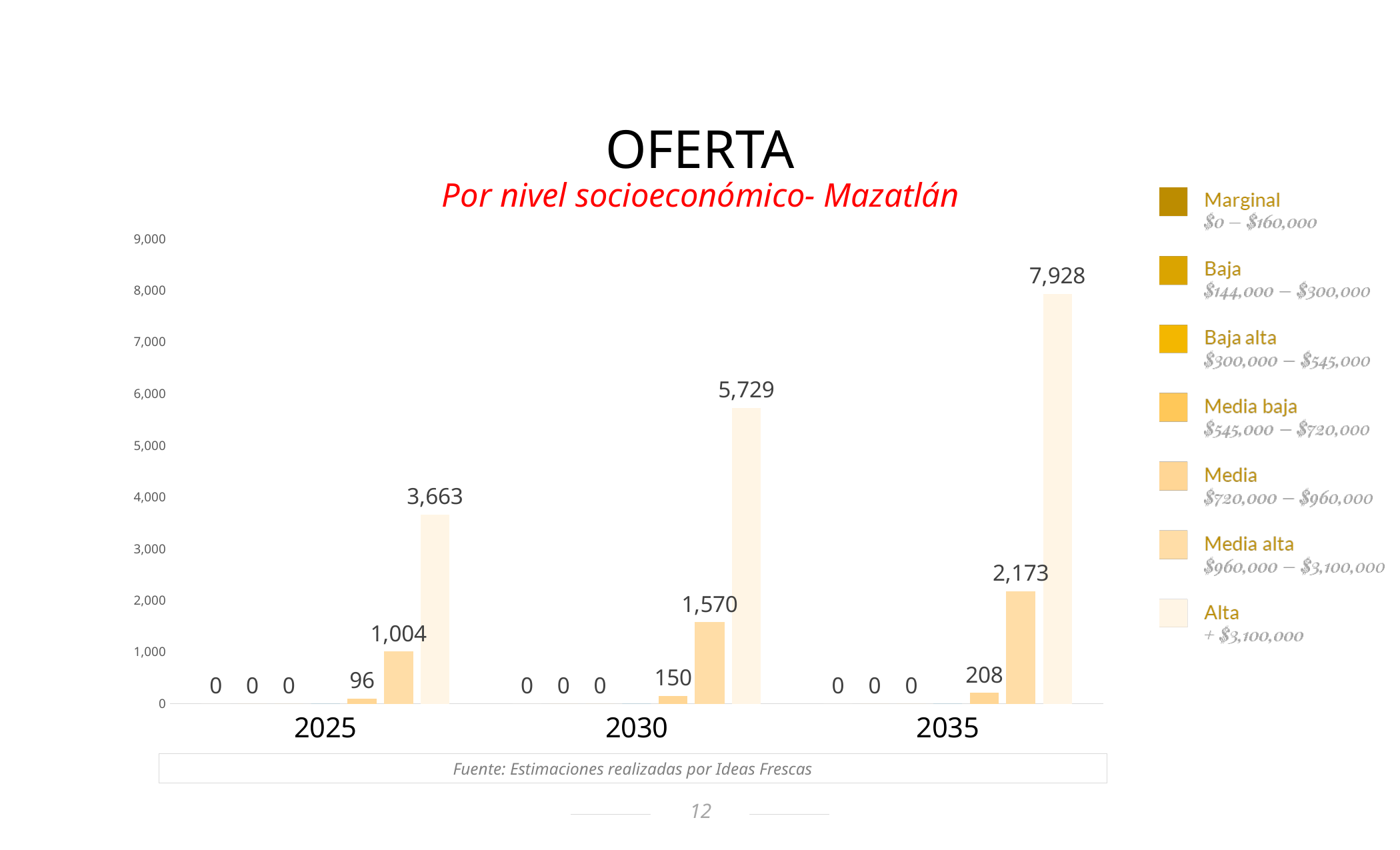
What is the difference between the second-tallest bar in 2035 (2,173) and the second-tallest bar in 2030 (1,570)? 603 What is the value of the tallest bar in the 2025 group? 3,663 What is the value of the tallest bar in the 2035 group? 7,928 What is the value of the tallest bar in the 2030 group? 5,729 What is the smallest non-zero value labelled in the 2030 group? 150 How many year groups are shown on the x axis? 3 Do the values of the tallest bars rise or fall from 2025 to 2035? rise Which year group contains the highest bar on the chart? 2035 What kind of chart is shown on the slide? bar chart Which is larger: the second-tallest bar in 2025 or the second-tallest bar in 2030? 2030 How many series does the legend list? 7 What is the difference between the tallest bar in 2035 (7,928) and the tallest bar in 2030 (5,729)? 2,199